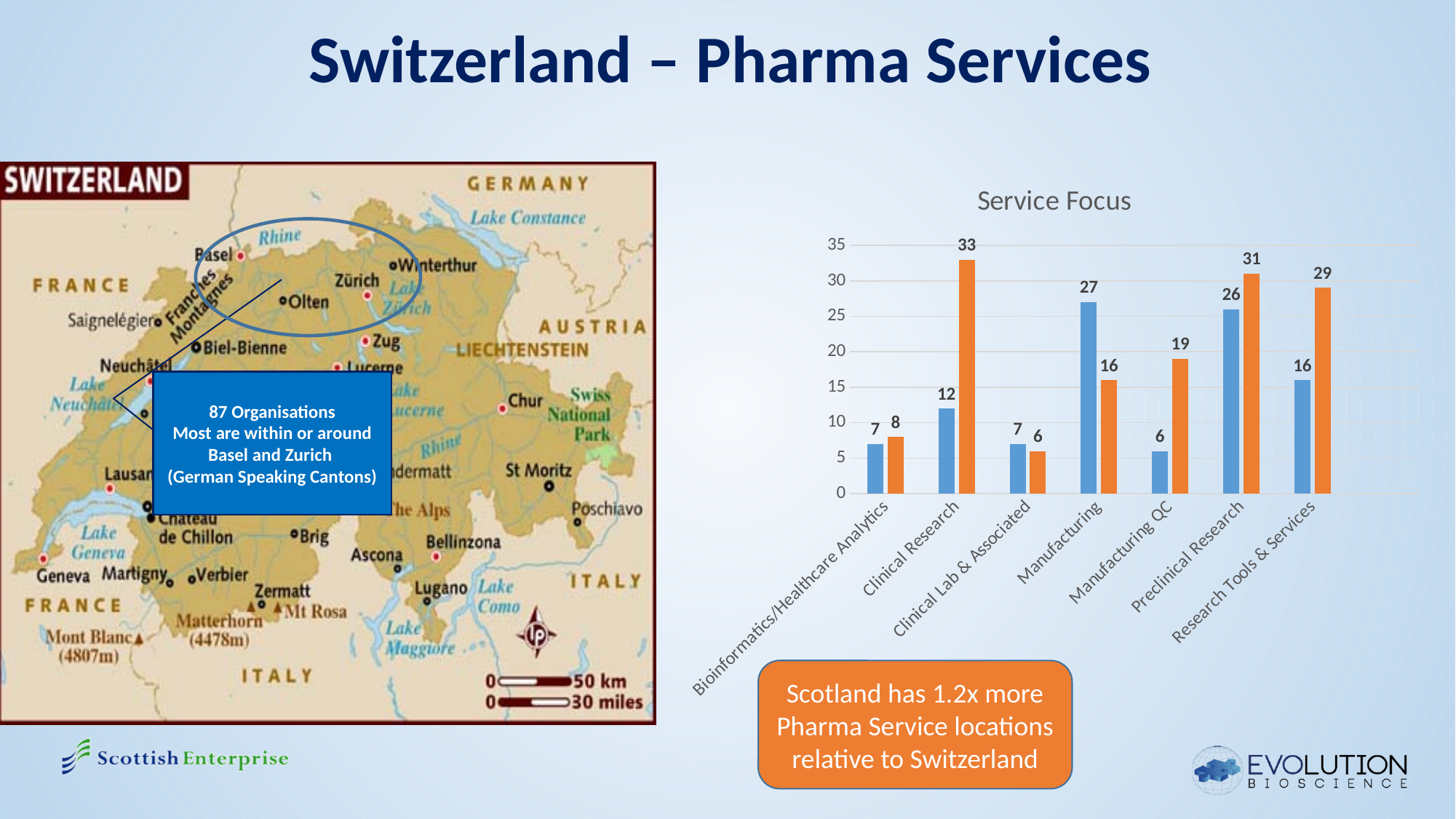
What is the value of the blue bar for Manufacturing? 27 Which is larger for Manufacturing, the blue bar or the orange bar? the blue bar Which category has the lowest blue bar? Manufacturing QC What is the value of the orange bar for Manufacturing QC? 19 What is the value of the orange bar for Clinical Research? 33 What is the title of the chart? Service Focus Which category has the highest orange bar? Clinical Research What is the difference between the orange and blue bars for Clinical Research? 21 What is the value of the blue bar for Research Tools & Services? 16 How many categories are shown on the x axis of the chart? 7 What is the difference between the orange bar for Preclinical Research and the orange bar for Research Tools & Services? 2 What type of chart is shown on the slide? bar chart